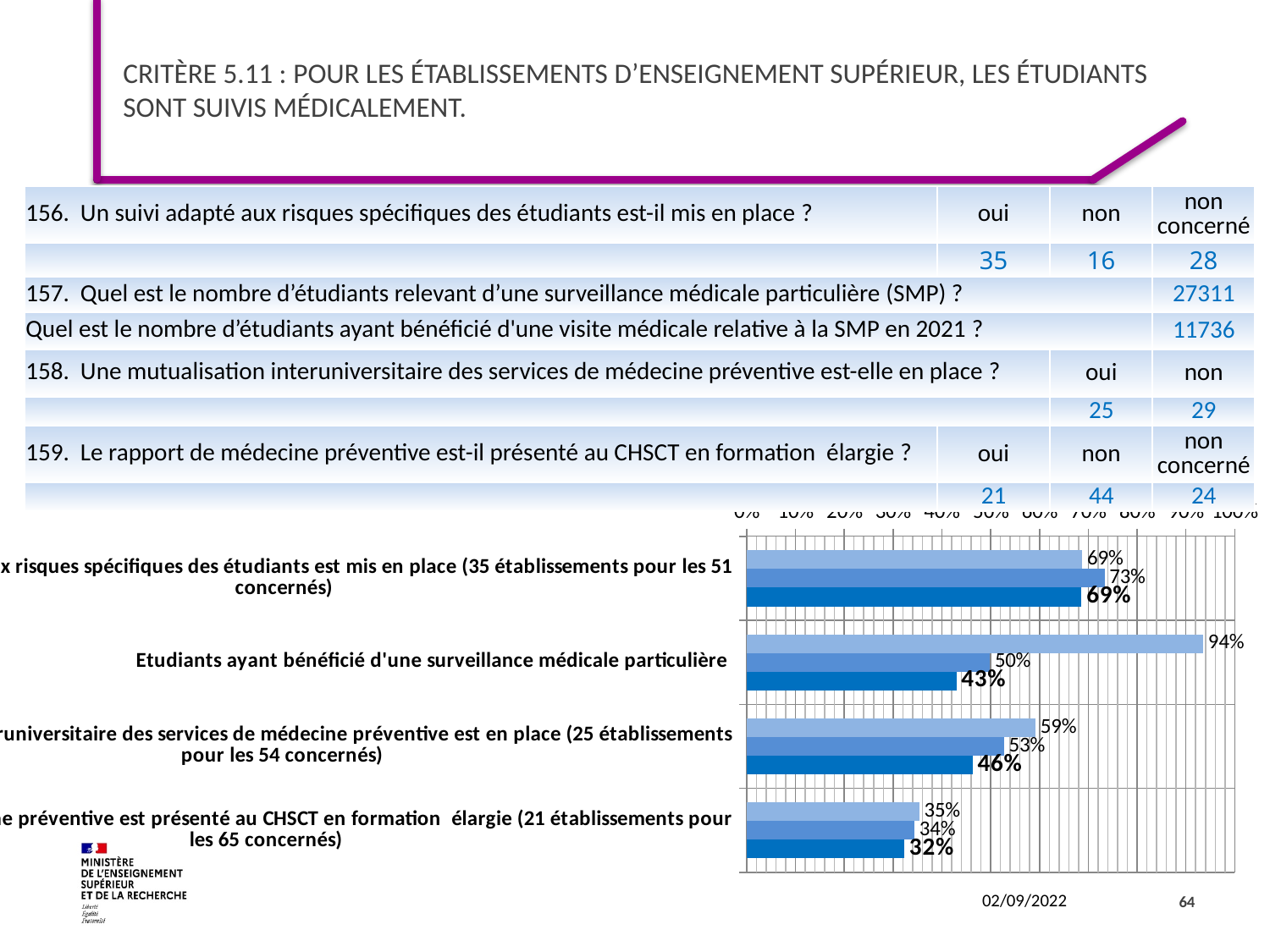
In the bar chart, what is the difference between the top bar (94%) and the bottom bar (43%) for "Etudiants ayant bénéficié d'une surveillance médicale particulière"? 51 percentage points What kind of chart is shown at the bottom of the slide? Bar chart In the bar chart, what is the value of the top (light blue) bar for "Etudiants ayant bénéficié d'une surveillance médicale particulière"? 94% In the bar chart, what is the value of the middle bar for the category ending "(21 établissements pour les 65 concernés)"? 34% How many bars are plotted for each category in the bar chart? 3 What is the lowest value shown in the bar chart? 32% In the bar chart, for the category ending "(25 établissements pour les 54 concernés)", which is larger: the top bar or the bottom bar? The top bar (59%) Which category in the bar chart contains the highest value of all the bars? Etudiants ayant bénéficié d'une surveillance médicale particulière In the bar chart, for the category ending "(21 établissements pour les 65 concernés)", what is the difference between the top bar (35%) and the bottom bar (32%)? 3 percentage points How many categories does the bar chart show? 4 In the bar chart, what is the value of the bottom (dark blue, bold-labelled) bar for "Etudiants ayant bénéficié d'une surveillance médicale particulière"? 43% In the bar chart, is the bottom bar for the category ending "(25 établissements pour les 54 concernés)" greater or less than 50%? less